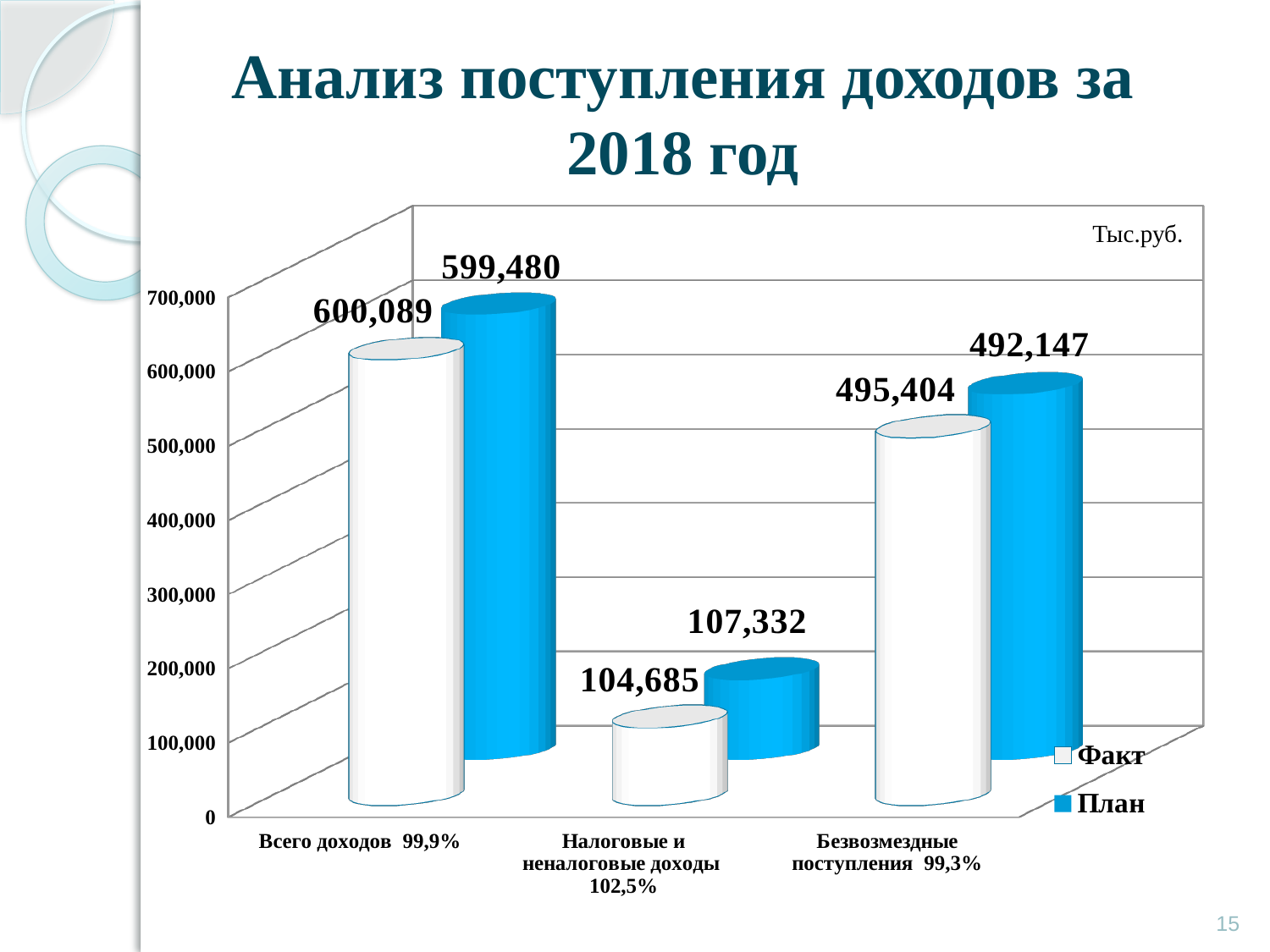
What is the title of the chart on the slide? Анализ поступления доходов за 2018 год What is the difference between the two values printed for Налоговые и неналоговые доходы? 2,647 How many categories are shown on the x axis? 3 What are the two series named in the legend? Факт and План What is the difference between the two values printed for Безвозмездные поступления? 3,257 What type of chart is shown on the slide? bar chart What two values are printed for the category Безвозмездные поступления? 495,404 and 492,147 What two values are printed for the category Налоговые и неналоговые доходы? 104,685 and 107,332 What is the highest value printed on the chart? 600,089 How many series does the legend list? 2 What is the lowest value printed on the chart? 104,685 What two values are printed for the category Всего доходов? 600,089 and 599,480